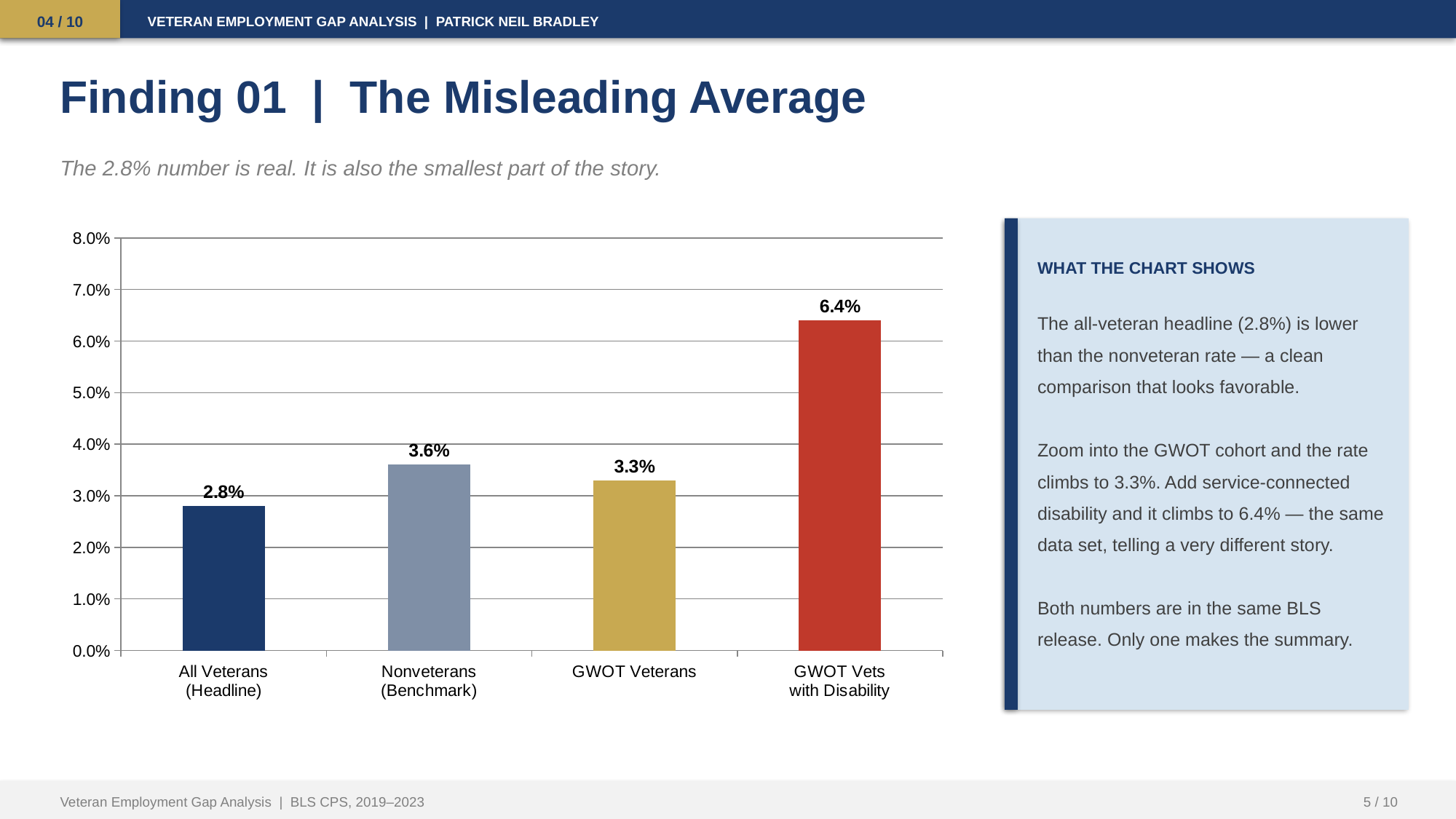
What is the value for All Veterans (Headline)? 2.8% What is the value for Nonveterans (Benchmark)? 3.6% What kind of chart is shown on the slide? bar chart Which category has the highest value? GWOT Vets with Disability Is the value for GWOT Vets with Disability greater or less than 6.0%? greater Which is larger, the value for Nonveterans (Benchmark) or the value for GWOT Veterans? Nonveterans (Benchmark) How many categories are shown on the x axis? 4 What is the difference between the values for GWOT Vets with Disability and All Veterans (Headline)? 3.6% What is the value for GWOT Veterans? 3.3% What is the value for GWOT Vets with Disability? 6.4% Which category has the lowest value? All Veterans (Headline) What is the difference between the values for Nonveterans (Benchmark) and GWOT Veterans? 0.3%